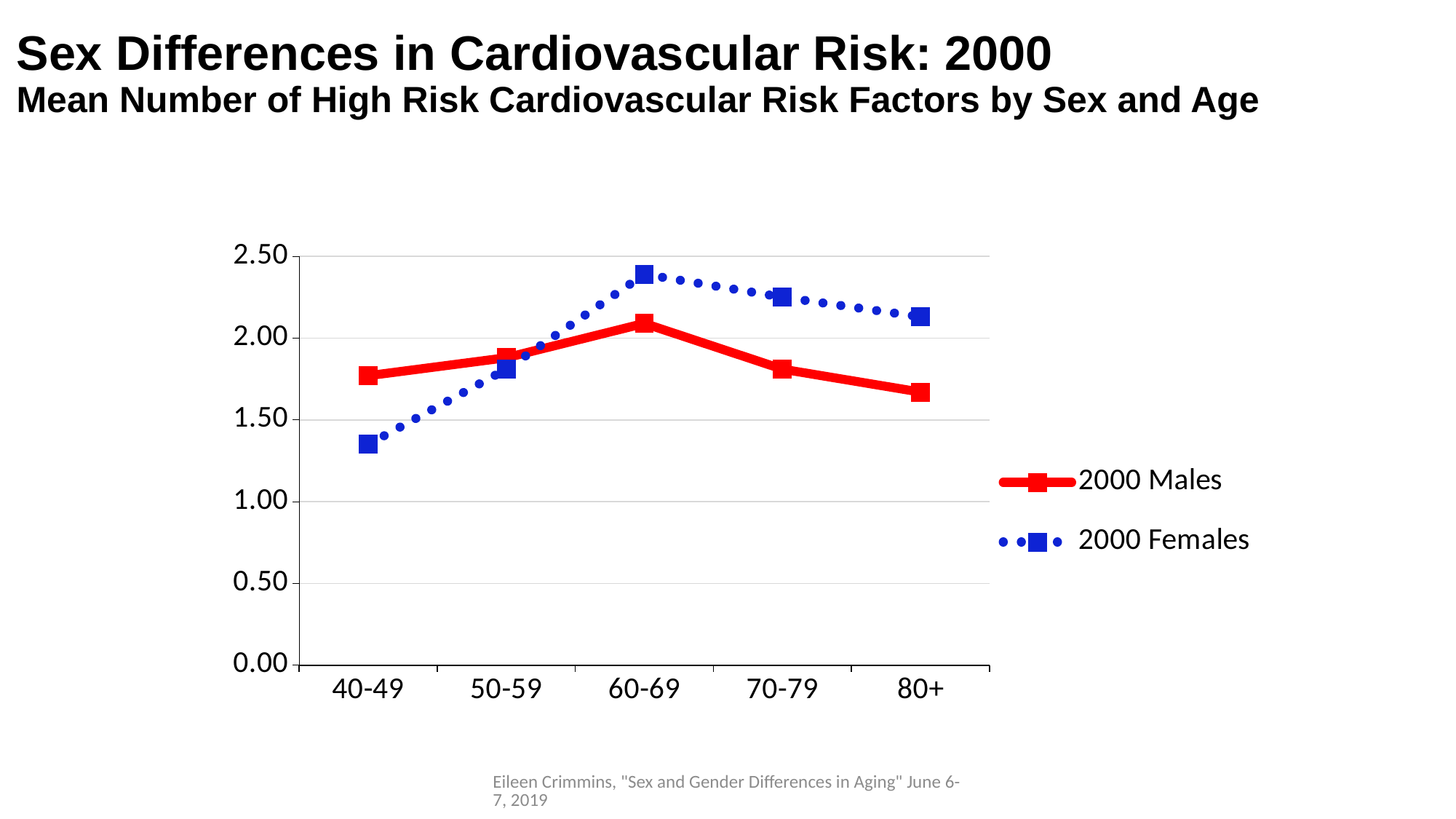
At age 40-49, which series has the larger value, 2000 Males or 2000 Females? 2000 Males How many age groups are shown on the x axis? 5 For which age group is the value for 2000 Males lowest? 80+ How many series does the legend list? 2 Is the value for 2000 Females at age 60-69 greater or less than 2.00? greater For which age group is the value for 2000 Females lowest? 40-49 At age 80+, which series has the larger value, 2000 Males or 2000 Females? 2000 Females For which age group is the value for 2000 Females highest? 60-69 Is the value for 2000 Females at age 40-49 greater or less than 1.50? less For which age group is the value for 2000 Males highest? 60-69 What kind of chart is shown on the slide? line chart Do the values for 2000 Males rise or fall from age 60-69 to 80+? fall